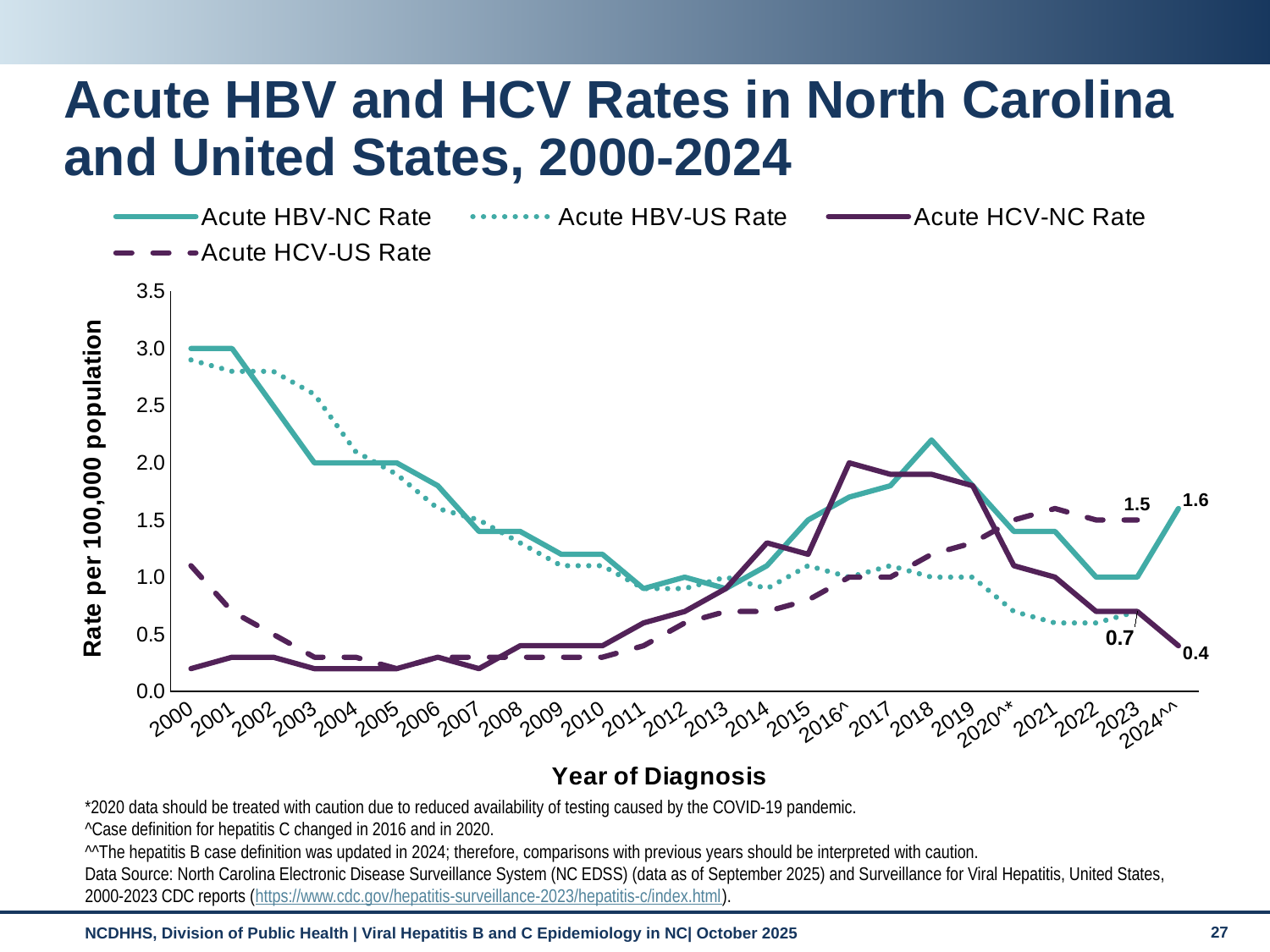
What is the Acute HBV-NC Rate for 2024^^? 1.6 How many series does the legend list? 4 What is the difference between the Acute HBV-NC Rate and the Acute HCV-NC Rate in 2024^^? 1.2 Is the Acute HBV-NC Rate for 2000 greater or less than 2.5? greater Is the Acute HCV-NC Rate for 2000 greater or less than 0.5? less What kind of chart is shown on the slide? line chart In which year does the Acute HCV-NC Rate reach its highest value? 2016^ In 2023, which is larger: the Acute HCV-US Rate or the Acute HCV-NC Rate? Acute HCV-US Rate What is the Acute HCV-US Rate for 2023? 1.5 How many years are shown along the x axis? 25 What is the Acute HCV-NC Rate for 2024^^? 0.4 What is the title of the x axis? Year of Diagnosis